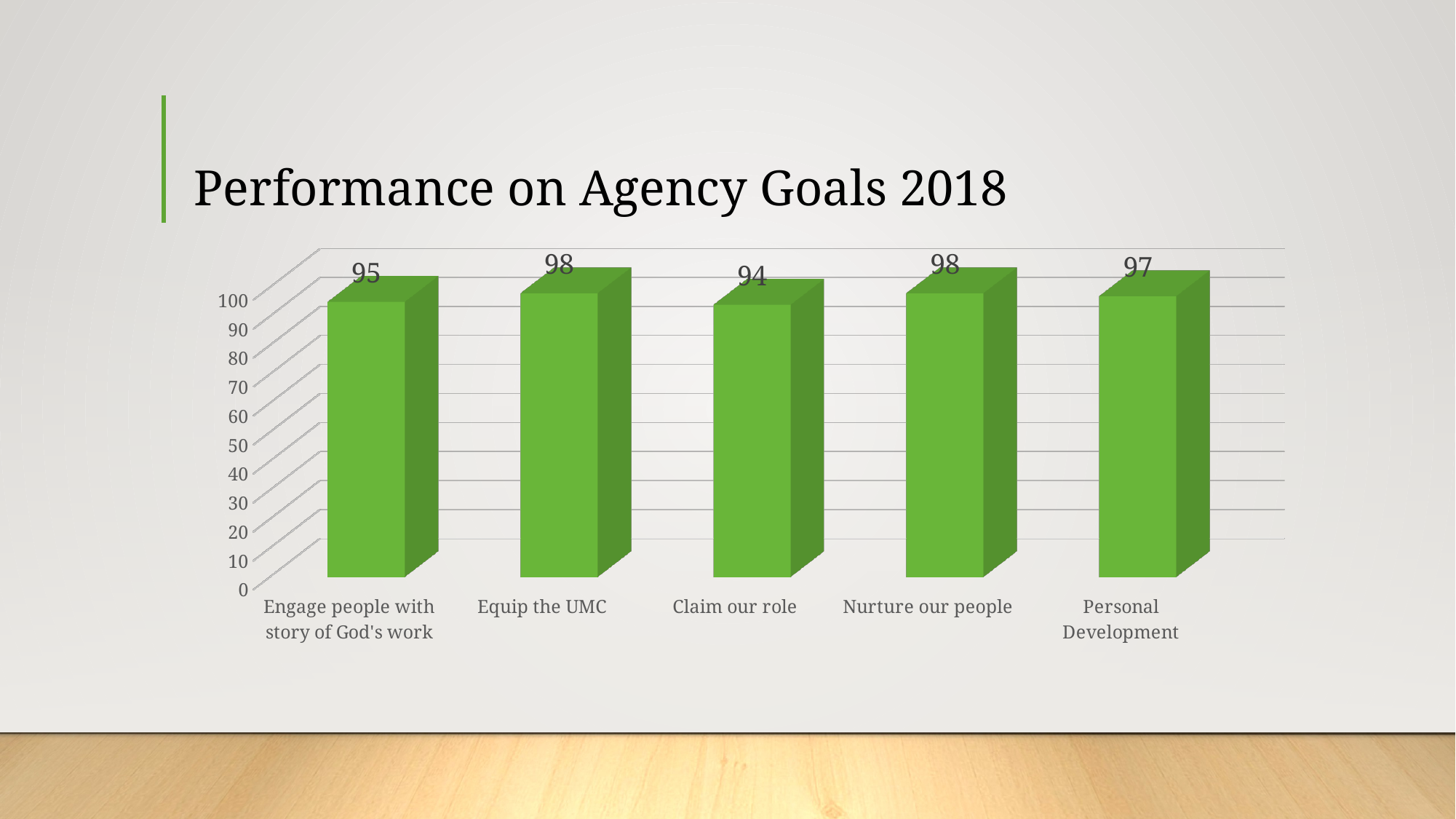
What is the title of the slide? Performance on Agency Goals 2018 How many categories are shown in the chart? 5 What is the value for Engage people with story of God's work? 95 What is the value for Personal Development? 97 What is the difference between the values for Personal Development and Engage people with story of God's work? 2 What is the value for Claim our role? 94 What kind of chart is shown on the slide? bar chart Which category has the lowest value? Claim our role Is the value for Claim our role greater or less than 90? greater What is the value for Equip the UMC? 98 Which is larger, the value for Nurture our people or the value for Engage people with story of God's work? Nurture our people What is the difference between the values for Equip the UMC and Claim our role? 4